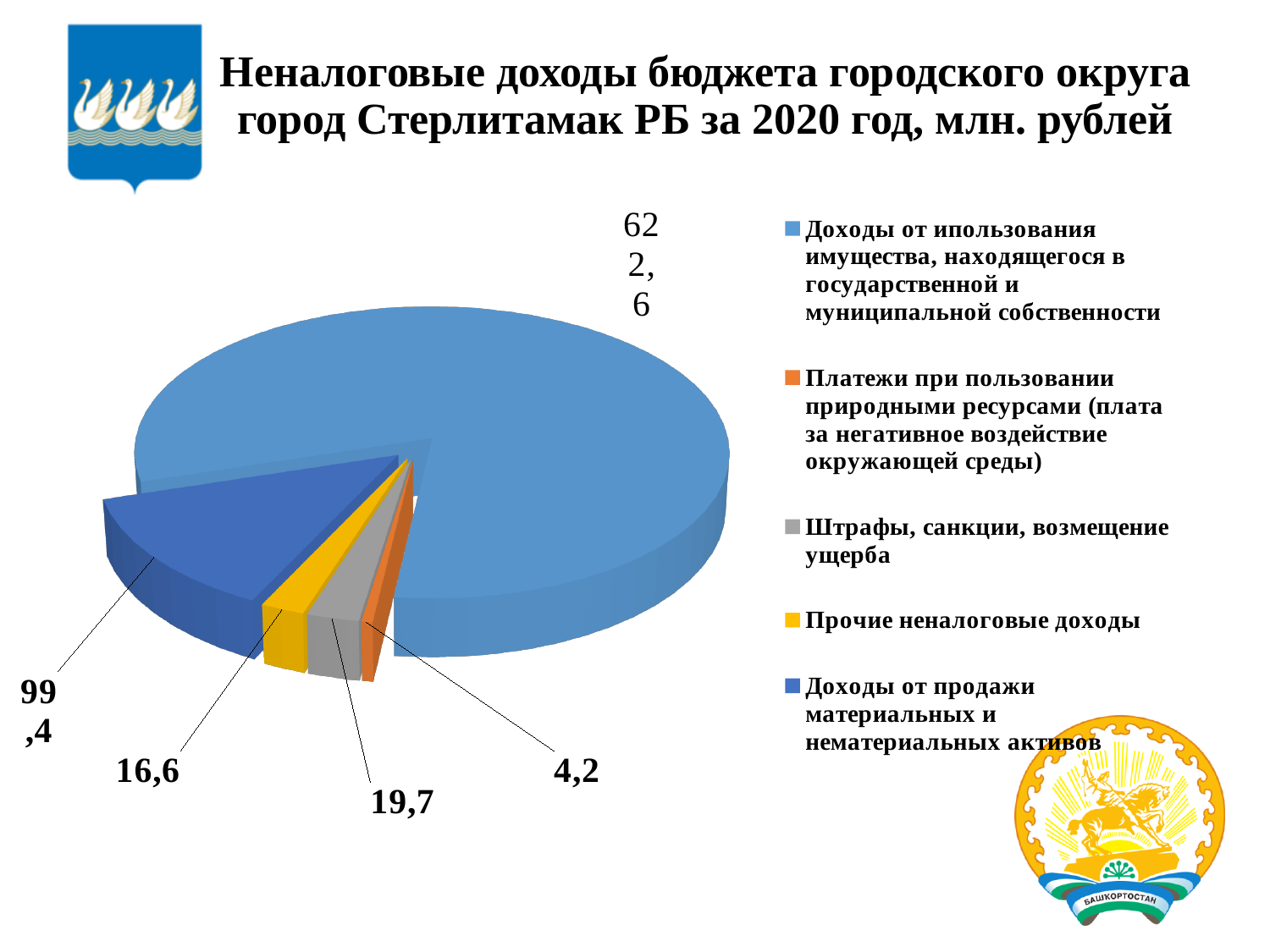
How many categories does the legend list? 5 What type of chart is shown on the slide? Pie chart What is the difference between «Доходы от продажи материальных и нематериальных активов» and «Штрафы, санкции, возмещение ущерба»? 79,7 What is the value for «Прочие неналоговые доходы»? 16,6 What is the value for «Доходы от ипользования имущества, находящегося в государственной и муниципальной собственности»? 622,6 Which is larger: «Штрафы, санкции, возмещение ущерба» or «Прочие неналоговые доходы»? Штрафы, санкции, возмещение ущерба What is the value for «Доходы от продажи материальных и нематериальных активов»? 99,4 What is the value for «Платежи при пользовании природными ресурсами (плата за негативное воздействие окружающей среды)»? 4,2 Which category has the largest slice of the pie? Доходы от ипользования имущества, находящегося в государственной и муниципальной собственности Which category has the smallest slice of the pie? Платежи при пользовании природными ресурсами (плата за негативное воздействие окружающей среды) What is the value for «Штрафы, санкции, возмещение ущерба»? 19,7 What colour is the slice for «Прочие неналоговые доходы»? Yellow